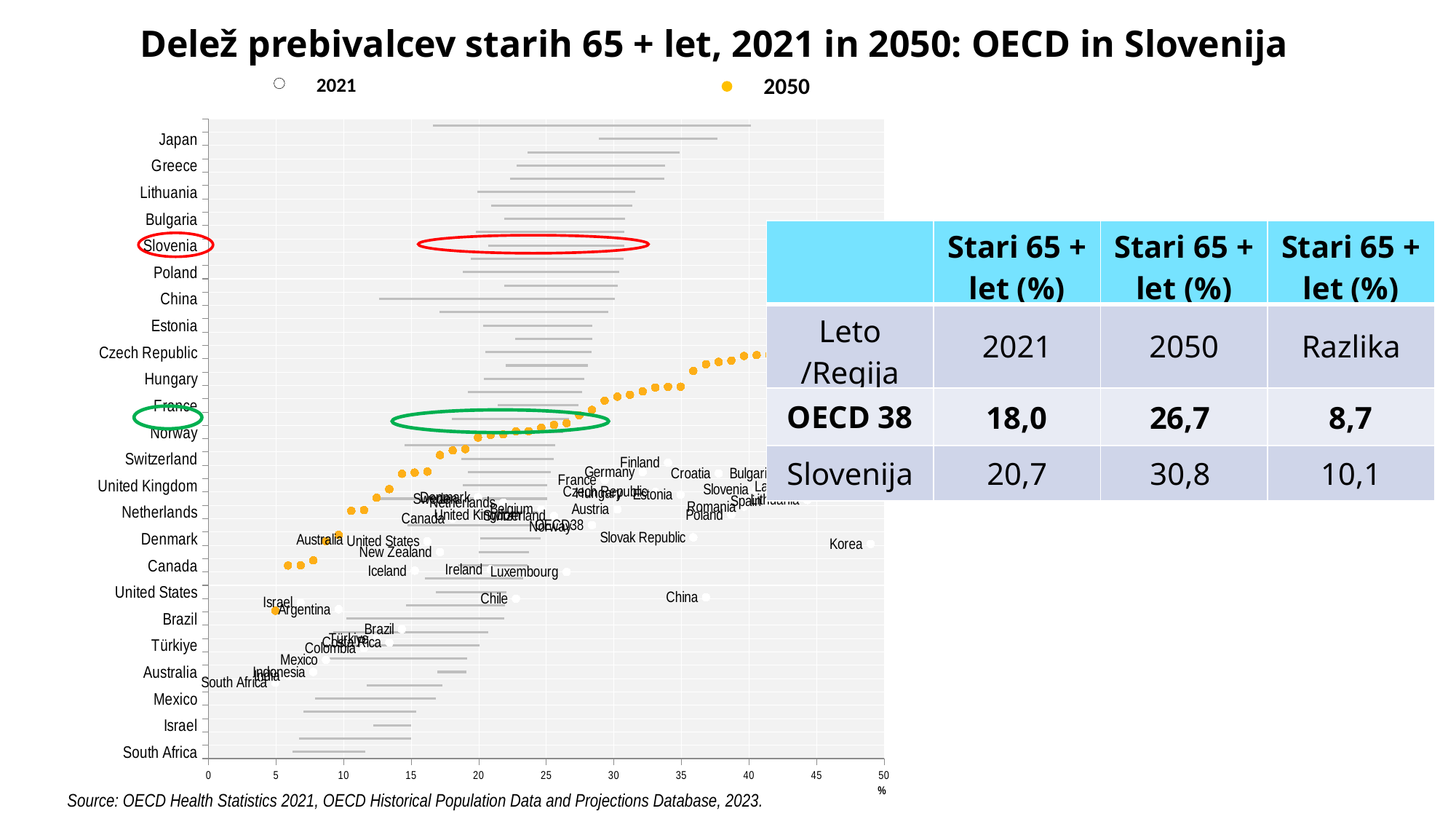
Which has the larger projected share of people aged 65+ in 2050, Slovenia or OECD 38? Slovenia According to the slide, what is the projected share of people aged 65+ for OECD 38 in 2050? 26,7 What unit is shown at the end of the chart's x axis? % According to the slide, what was the share of people aged 65+ for OECD 38 in 2021? 18,0 Which has the larger share of people aged 65+ in 2021, Slovenia or OECD 38? Slovenia What is the difference (Razlika) between the 2050 and 2021 shares for OECD 38 shown on the slide? 8,7 What are the two series named in the chart legend? 2021 and 2050 According to the slide, what was the share of people aged 65+ in Slovenia in 2021? 20,7 How many series does the chart legend list? 2 What is the difference (Razlika) between the 2050 and 2021 shares for Slovenia shown on the slide? 10,1 Is the 2050 share for Slovenia greater or less than 30? greater According to the slide, what is the projected share of people aged 65+ in Slovenia in 2050? 30,8